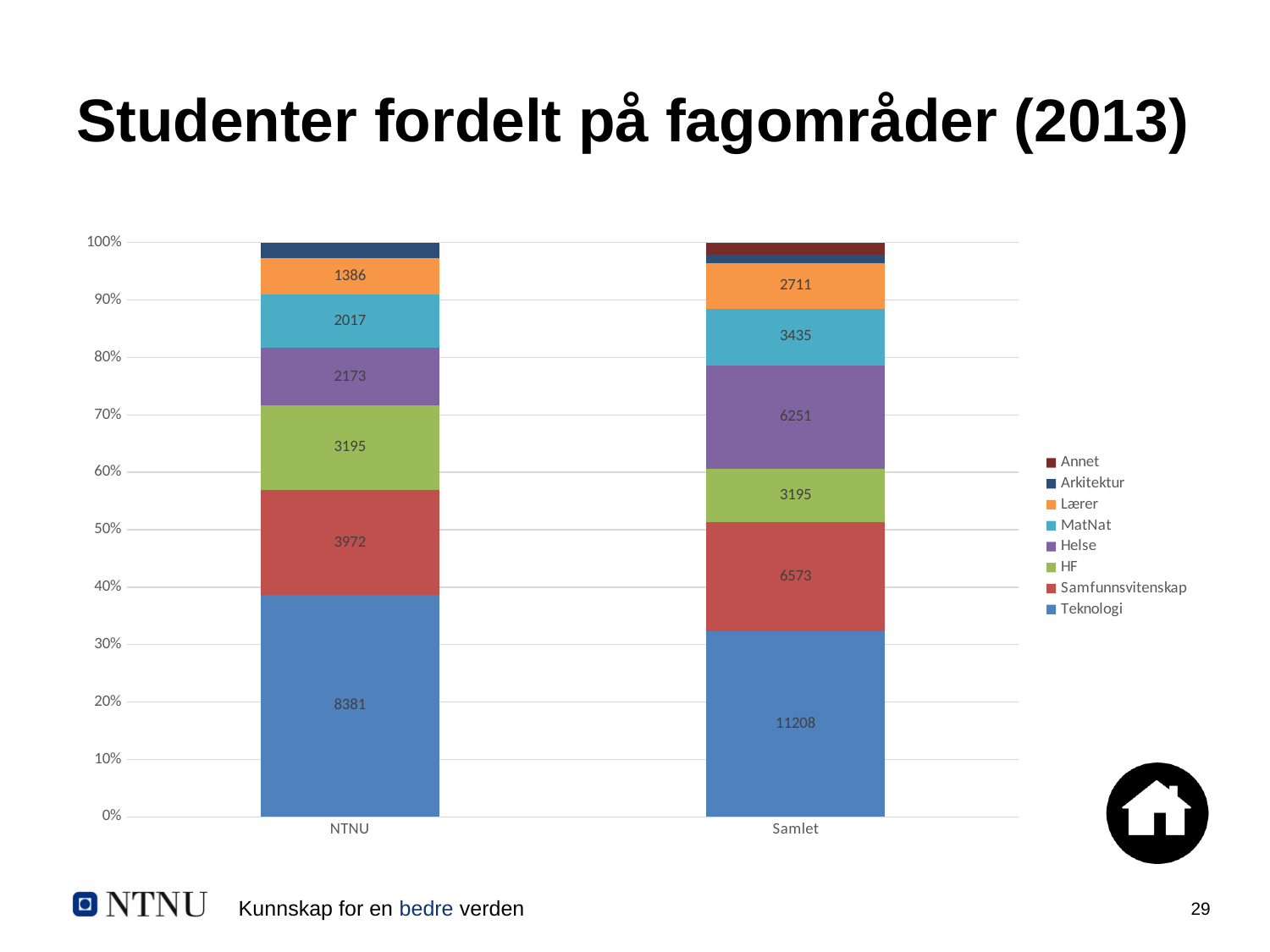
How many categories (bars) are shown on the x axis? 2 Does the top of the Teknologi segment in the Samlet bar lie above or below the 40% line? below What is the difference between the Samfunnsvitenskap values for Samlet and NTNU? 2601 What kind of chart is shown on the slide? Stacked bar chart What is the value of the MatNat segment for Samlet? 3435 What is the value of the Teknologi segment for NTNU? 8381 Which is larger for Samlet: the Helse value or the MatNat value? Helse What is the value of the Helse segment for Samlet? 6251 What is the value of the Lærer segment for NTNU? 1386 What is the difference between the Teknologi values for Samlet and NTNU? 2827 How many series does the legend list? 8 Which series has the largest value in the NTNU bar? Teknologi